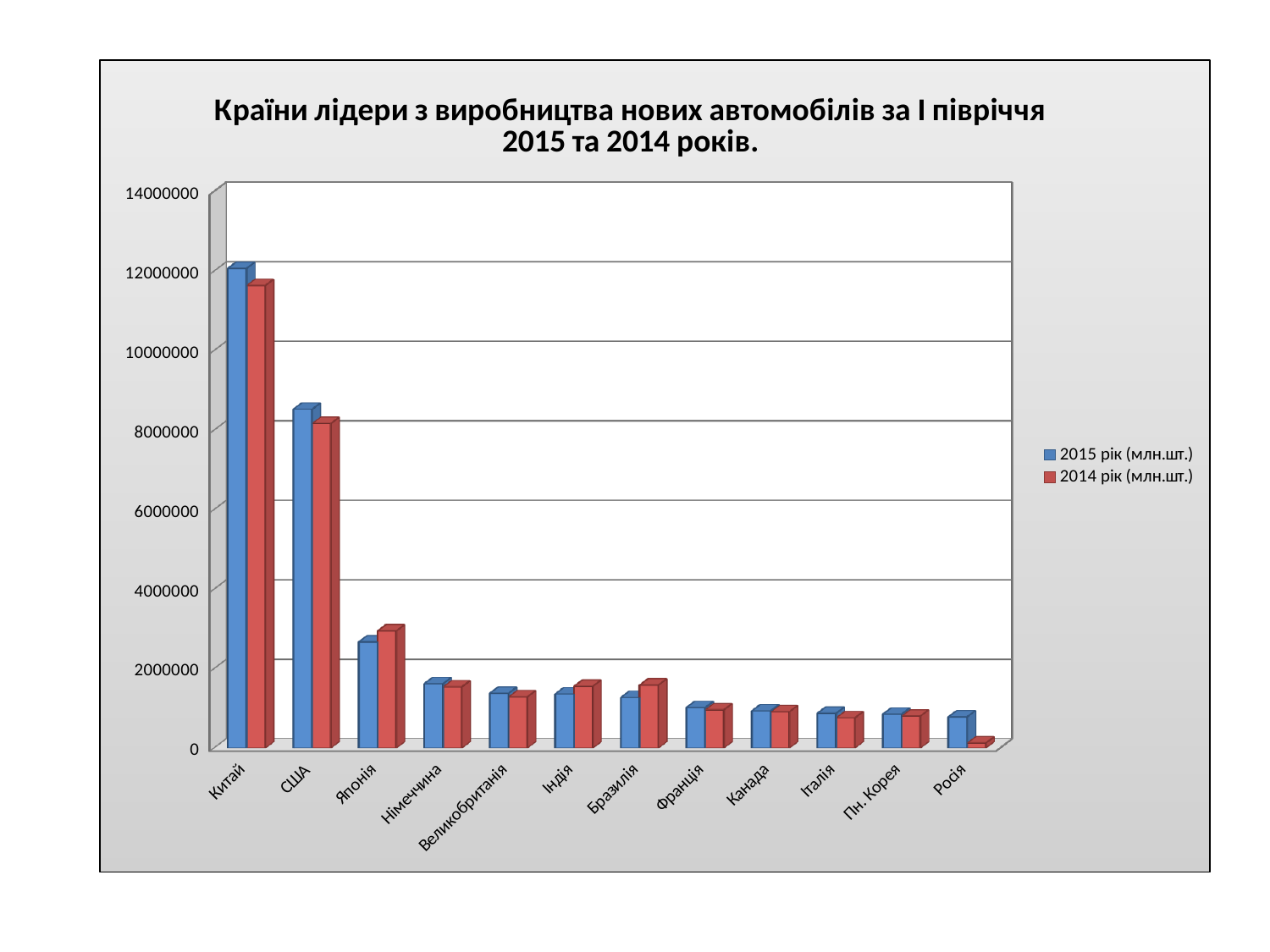
Is the 2015 value for США greater or less than 8000000? greater What are the two legend entries of the chart? 2015 рік (млн.шт.) and 2014 рік (млн.шт.) Which country has the lowest value for 2014 рік (млн.шт.)? Росія How many countries are shown on the x axis? 12 Is the 2015 value for Китай greater or less than 10000000? greater Is the 2014 value for Японія greater or less than 4000000? less For Японія, which is larger: the 2015 value or the 2014 value? 2014 Which country has the highest value for 2015 рік (млн.шт.)? Китай What kind of chart is shown on the slide? bar chart How many series does the legend list? 2 For Китай, which is larger: the 2015 value or the 2014 value? 2015 Do the 2015 values generally rise or fall moving from Китай to Росія along the x axis? fall